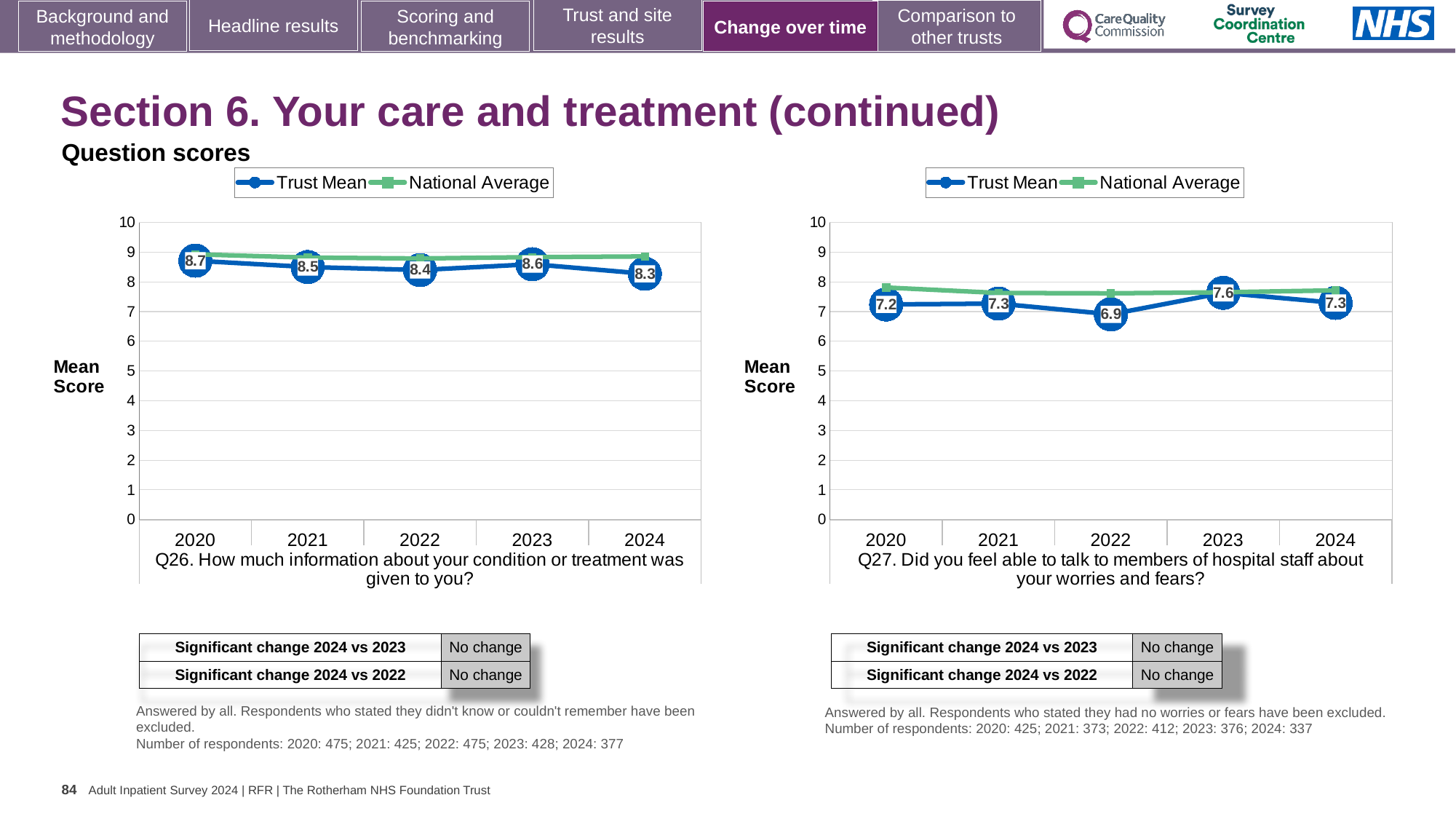
In the Q27 chart (right), which year has the highest Trust Mean score? 2023 In the Q27 chart (right), which year has the lowest Trust Mean score? 2022 In the Q26 chart (left), is the Trust Mean score higher in 2021 or in 2023? 2023 In the Q27 chart (right), is the National Average value for 2020 greater or less than 7? greater How many series does the legend of the Q27 chart (right) list? 2 What kind of chart is used for Q26 (left)? Line chart In the Q27 chart (right), what is the difference between the Trust Mean scores for 2023 and 2022? 0.7 In the Q27 chart (right), what is the Trust Mean score for 2022? 6.9 In the Q26 chart (left), which year has the highest Trust Mean score? 2020 How many years are plotted on the x axis of the Q26 chart (left)? 5 In the Q26 chart (left), what is the difference between the Trust Mean scores for 2020 and 2024? 0.4 In the Q26 chart (left), what is the Trust Mean score for 2024? 8.3